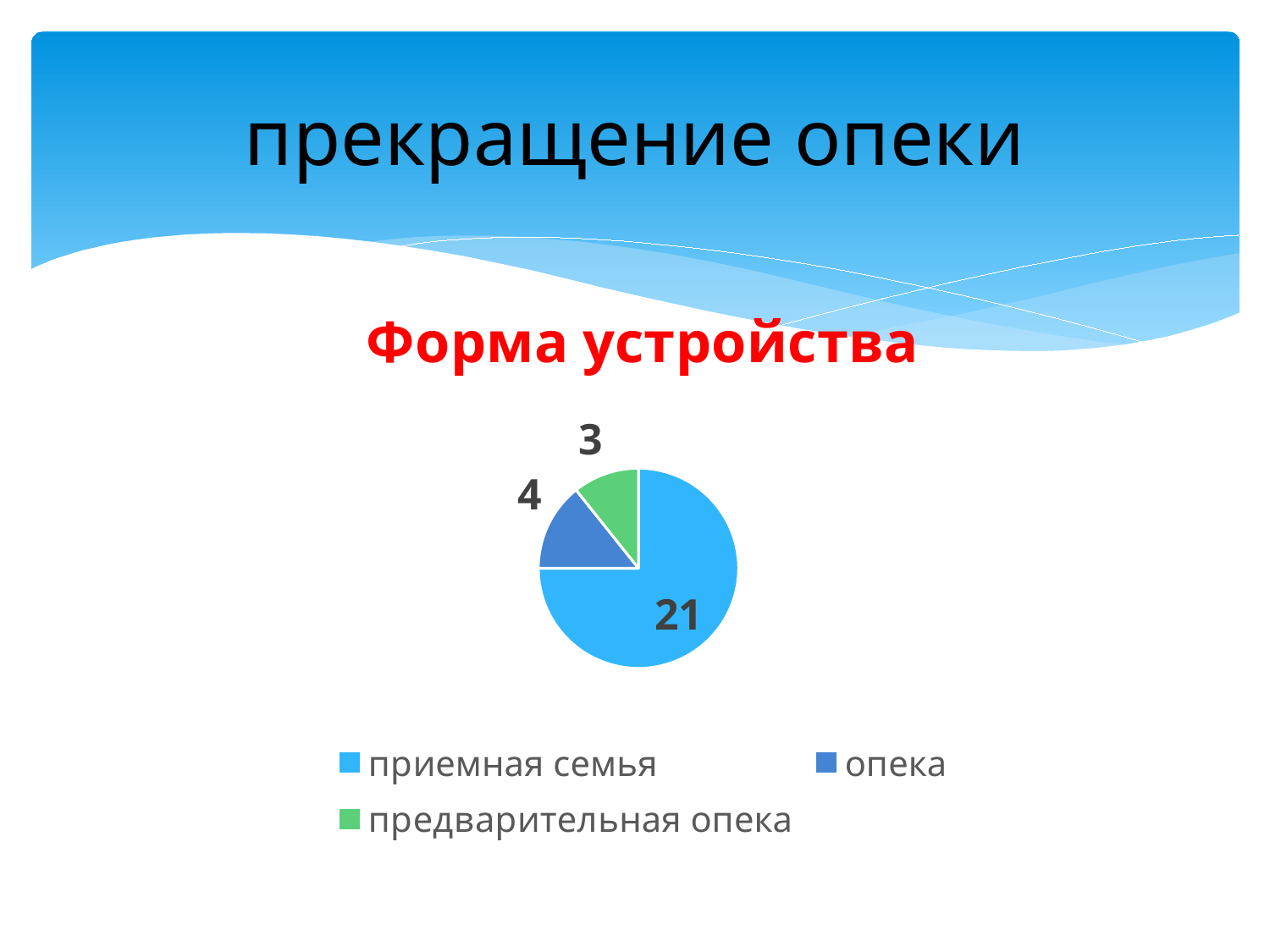
What is the title of the chart? Форма устройства What is the value for предварительная опека? 3 Which category has the largest slice of the pie? приемная семья What share of the pie does приемная семья represent? 75% What is the difference between the values for приемная семья and опека? 17 Which is larger, the value for опека or the value for предварительная опека? опека What is the value for опека? 4 What kind of chart is shown on the slide? pie chart Which category has the smallest slice of the pie? предварительная опека What is the value for приемная семья? 21 What is the total of all slices in the pie chart? 28 How many slices does the pie chart have? 3